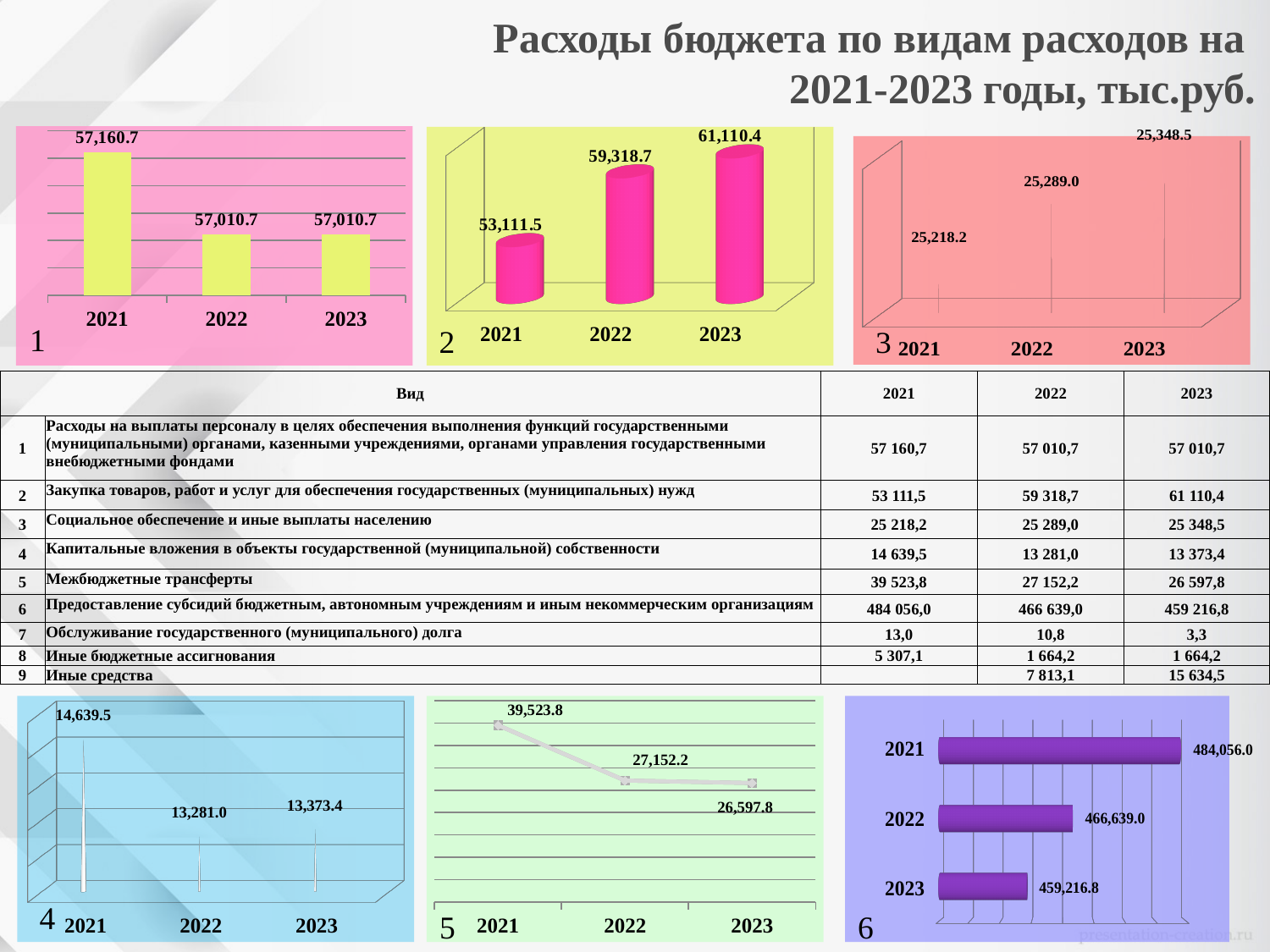
In chart 3 (top-right), what is the value for 2022? 25,289.0 Do the values in chart 2 (top-middle) rise or fall from 2021 to 2023? rise How many years are plotted in chart 6 (bottom-right)? 3 In chart 2 (top-middle), what is the value for 2023? 61,110.4 In chart 1 (top-left), what is the difference between the 2021 value and the 2022 value? 150.0 In chart 2 (top-middle), which year has the lowest value? 2021 What kind of chart is chart 5 (bottom-middle)? line chart In chart 5 (bottom-middle), which is larger, the value for 2021 or the value for 2023? 2021 In chart 4 (bottom-left), which year has the highest value? 2021 In chart 1 (top-left), what is the value for 2021? 57,160.7 Do the values in chart 6 (bottom-right) rise or fall from 2021 to 2023? fall In chart 6 (bottom-right), what is the difference between the 2021 value and the 2023 value? 24,839.2